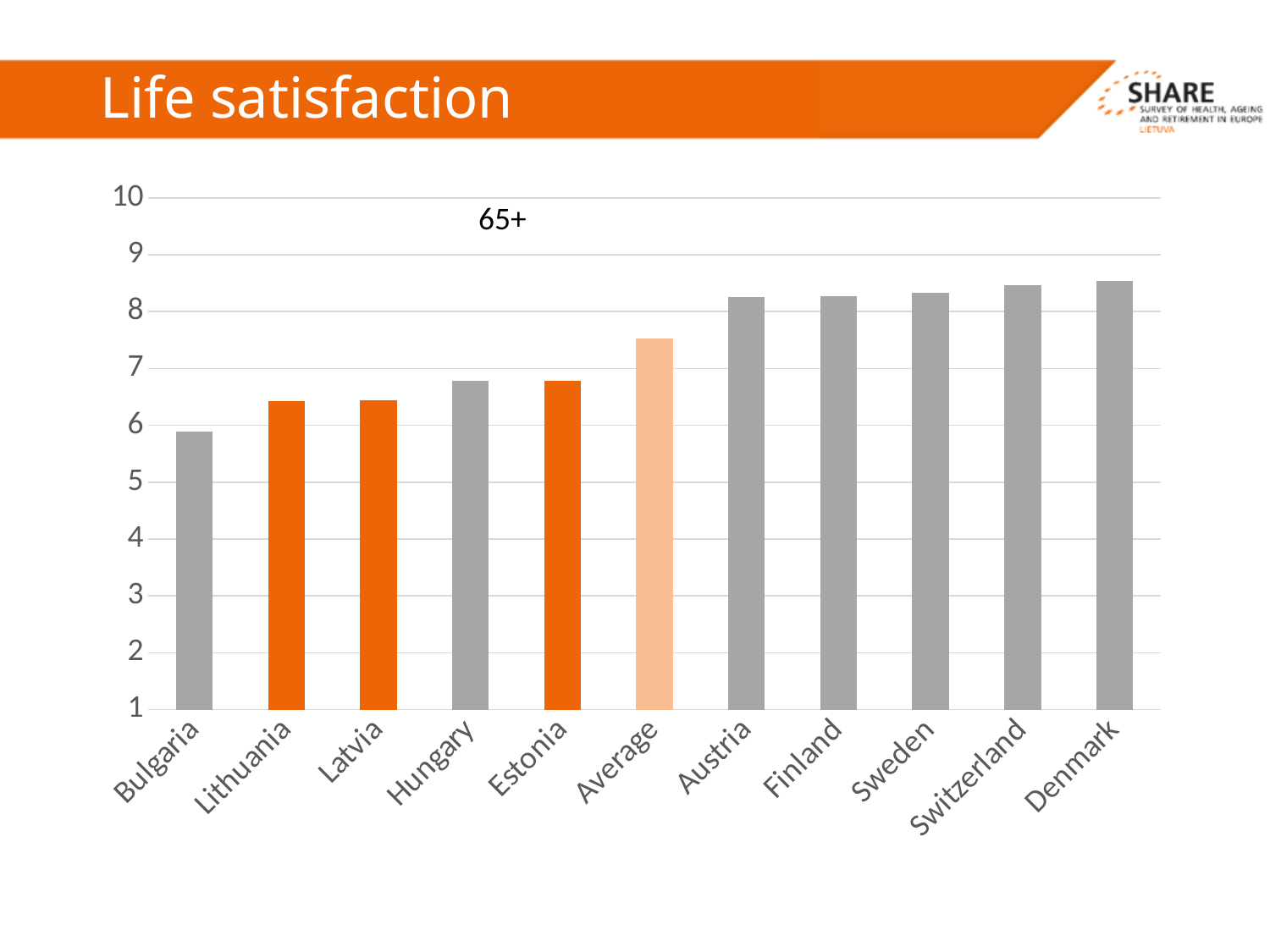
Is the value for Hungary greater or less than 7? less Is the value for Average greater or less than 7? greater What kind of chart is shown on the slide? bar chart Do the values generally rise or fall moving from left to right along the x axis? rise What label is printed above the bars inside the chart area? 65+ Which is larger, the value for Average or the value for Hungary? Average Is the value for Denmark greater or less than 8? greater Which category has the lowest life satisfaction value in the chart? Bulgaria Which is larger, the value for Austria or the value for Estonia? Austria How many countries or categories are shown on the x axis of the chart? 11 Which category has the highest life satisfaction value in the chart? Denmark